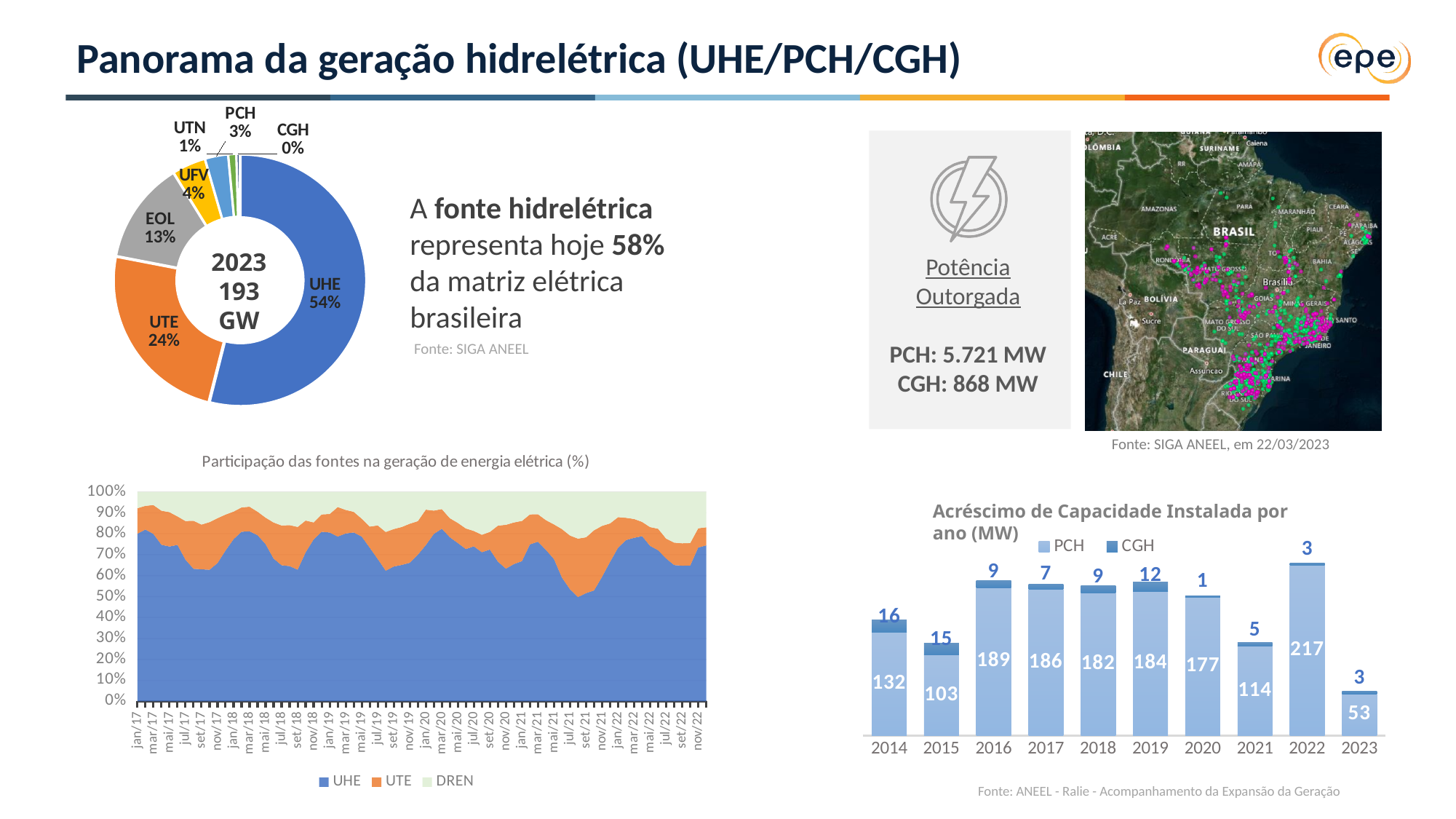
In the donut chart at the top left, what share does UTE have? 24% In the chart 'Acréscimo de Capacidade Instalada por ano (MW)', what is the total of the stacked bar for 2014? 148 In the donut chart at the top left, what is the difference between the EOL share and the UFV share? 9% In the donut chart at the top left, which category has the largest share? UHE In the chart 'Acréscimo de Capacidade Instalada por ano (MW)', what is the PCH value for 2022? 217 In the chart 'Acréscimo de Capacidade Instalada por ano (MW)', what is the CGH value for 2019? 12 What kind of chart is 'Participação das fontes na geração de energia elétrica (%)'? Stacked area chart In the donut chart at the top left, how many categories are labelled? 7 In the donut chart at the top left, what share does UHE have? 54% In the chart 'Acréscimo de Capacidade Instalada por ano (MW)', which year has the lowest PCH value? 2023 In the chart 'Acréscimo de Capacidade Instalada por ano (MW)', how many series does the legend list? 2 In the chart 'Acréscimo de Capacidade Instalada por ano (MW)', which is larger, the PCH value for 2016 or for 2017? 2016